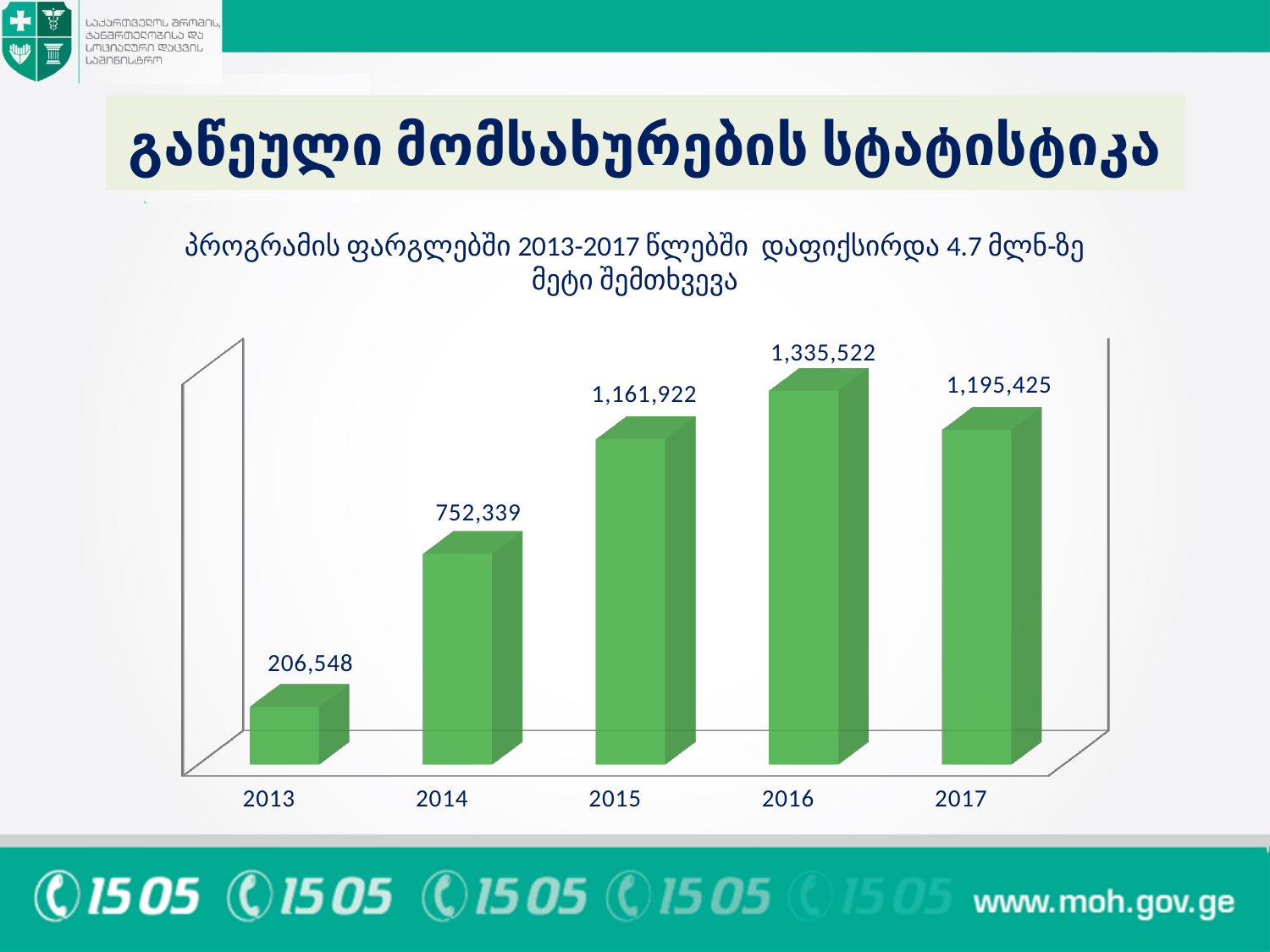
What is the value for 2016? 1,335,522 What is the difference between the values for 2016 and 2017? 140,097 What is the value for 2013? 206,548 How many years are shown on the x axis? 5 What is the value for 2014? 752,339 Which is larger, the value for 2015 or the value for 2017? 2017 Which year has the highest value? 2016 What is the value for 2015? 1,161,922 Which year has the lowest value? 2013 What is the value for 2017? 1,195,425 What is the difference between the values for 2016 and 2015? 173,600 What kind of chart is shown on the slide? bar chart